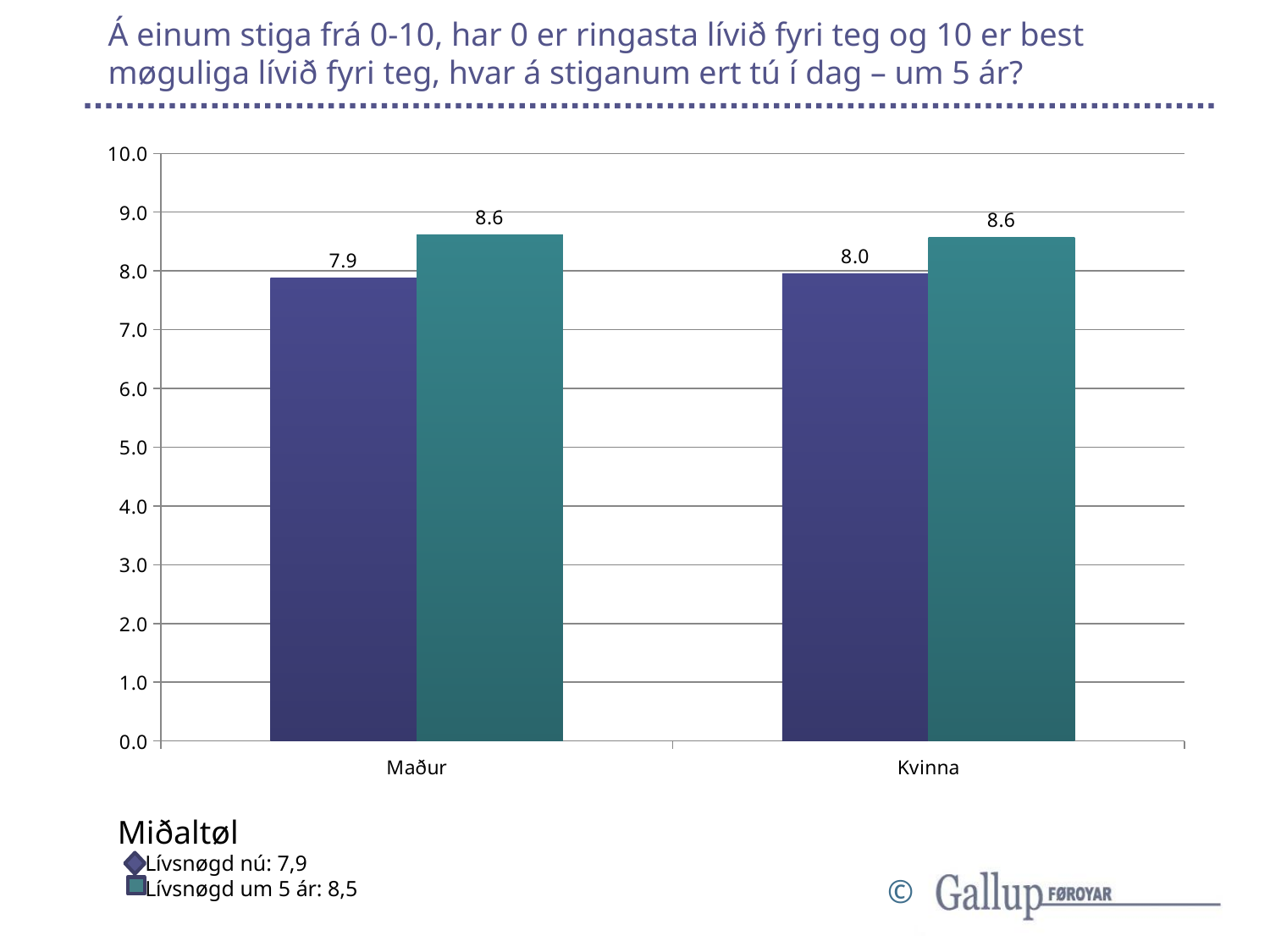
How many categories are shown on the x axis? 2 What is the value of Lívsnøgd nú for Maður? 7.9 What is the difference between Lívsnøgd um 5 ár and Lívsnøgd nú for Kvinna? 0.6 How many series does the legend list? 2 What average (Miðaltøl) does the legend give for Lívsnøgd um 5 ár? 8,5 Is the value of Lívsnøgd nú for Maður greater or less than 8.0? less For Maður, which is larger: Lívsnøgd nú or Lívsnøgd um 5 ár? Lívsnøgd um 5 ár What is the value of Lívsnøgd um 5 ár for Maður? 8.6 What is the value of Lívsnøgd um 5 ár for Kvinna? 8.6 What kind of chart is shown on the slide? bar chart What is the value of Lívsnøgd nú for Kvinna? 8.0 What is the difference between Lívsnøgd um 5 ár and Lívsnøgd nú for Maður? 0.7